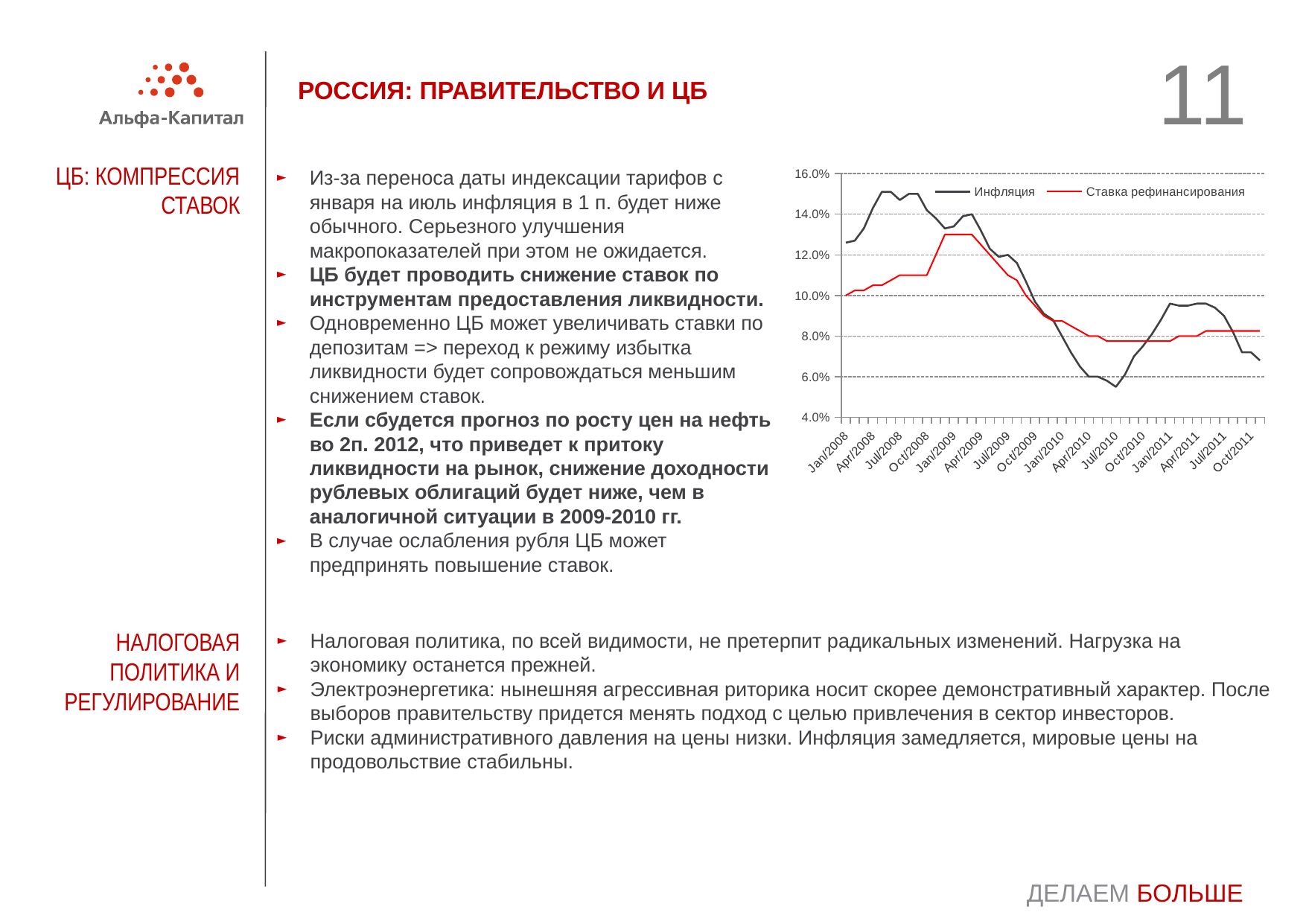
Is the value of Инфляция at Jul/2010 greater or less than 8.0%? less Is the value of Ставка рефинансирования at Oct/2011 greater or less than 10.0%? less Which colour is used for the Ставка рефинансирования line? red At Jan/2008, which series has the higher value, Инфляция or Ставка рефинансирования? Инфляция What are the two series named in the chart legend? Инфляция and Ставка рефинансирования At Jul/2010, which series has the higher value, Инфляция or Ставка рефинансирования? Ставка рефинансирования Does the Ставка рефинансирования line rise or fall between Jan/2008 and Jan/2009? rise Is the value of Инфляция at Jan/2008 greater or less than 12.0%? greater Does the Инфляция line rise or fall between Apr/2009 and Jul/2010? fall How many series does the chart legend list? 2 What kind of chart is shown on the slide? line chart